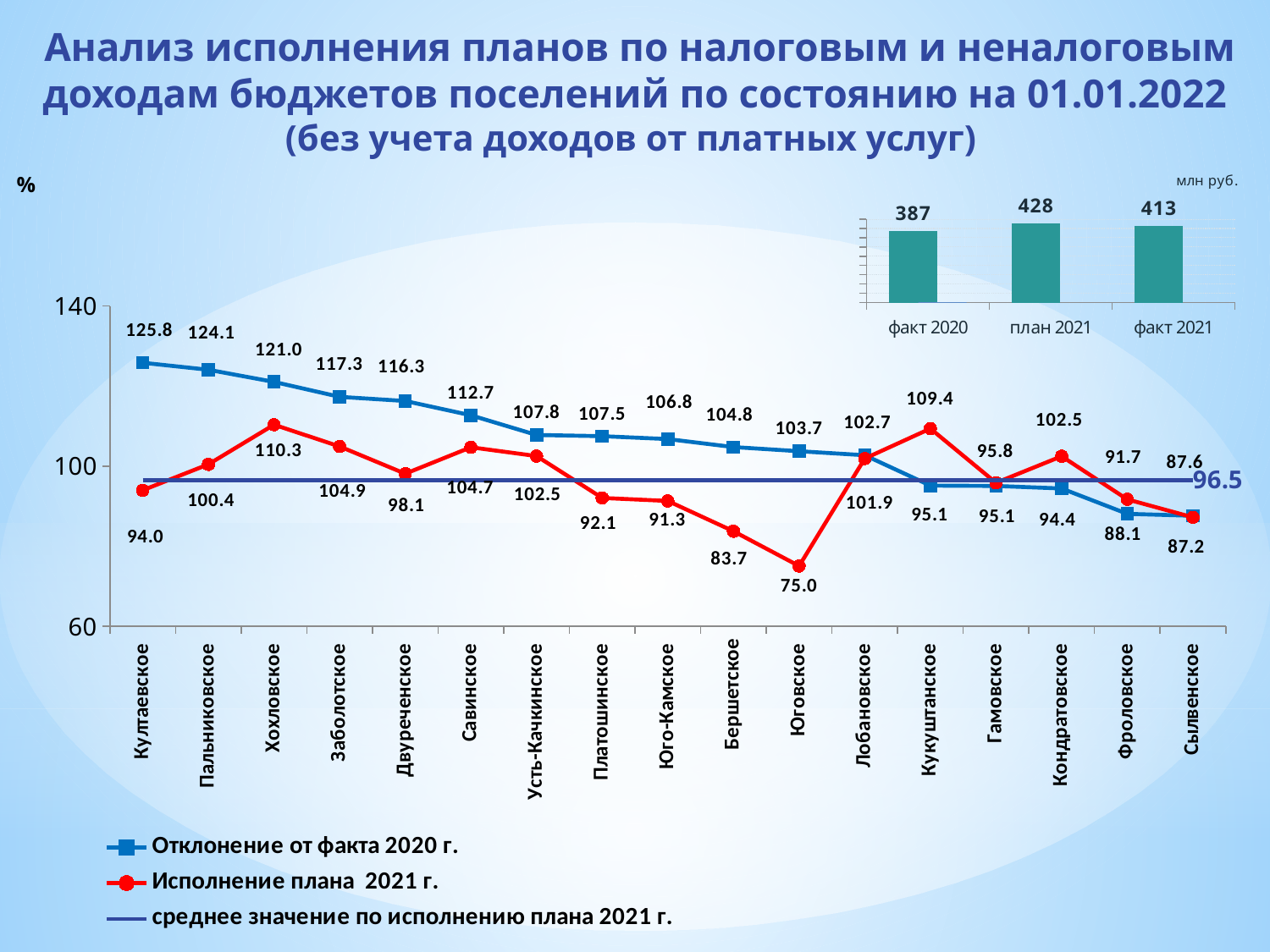
In the large line chart, which category has the highest value for Исполнение плана 2021 г.? Хохловское In the large line chart, which is larger for Кукуштанское: Отклонение от факта 2020 г. or Исполнение плана 2021 г.? Исполнение плана 2021 г. In the small bar chart in the top right, what is the difference between план 2021 and факт 2021? 15 In the large line chart, which category has the lowest value for Отклонение от факта 2020 г.? Сылвенское In the large line chart, what is the difference between Отклонение от факта 2020 г. and Исполнение плана 2021 г. for Култаевское? 31.8 In the large line chart, what is the value of Отклонение от факта 2020 г. for Хохловское? 121.0 In the small bar chart in the top right, how many bars are there? 3 In the large line chart, what is the value of Исполнение плана 2021 г. for Юговское? 75.0 In the small bar chart in the top right, which category has the lowest value? факт 2020 In the large line chart, what is the value of the среднее значение по исполнению плана 2021 г. line? 96.5 In the small bar chart in the top right, what is the value for план 2021? 428 In the large line chart, how many categories are shown on the x axis? 17